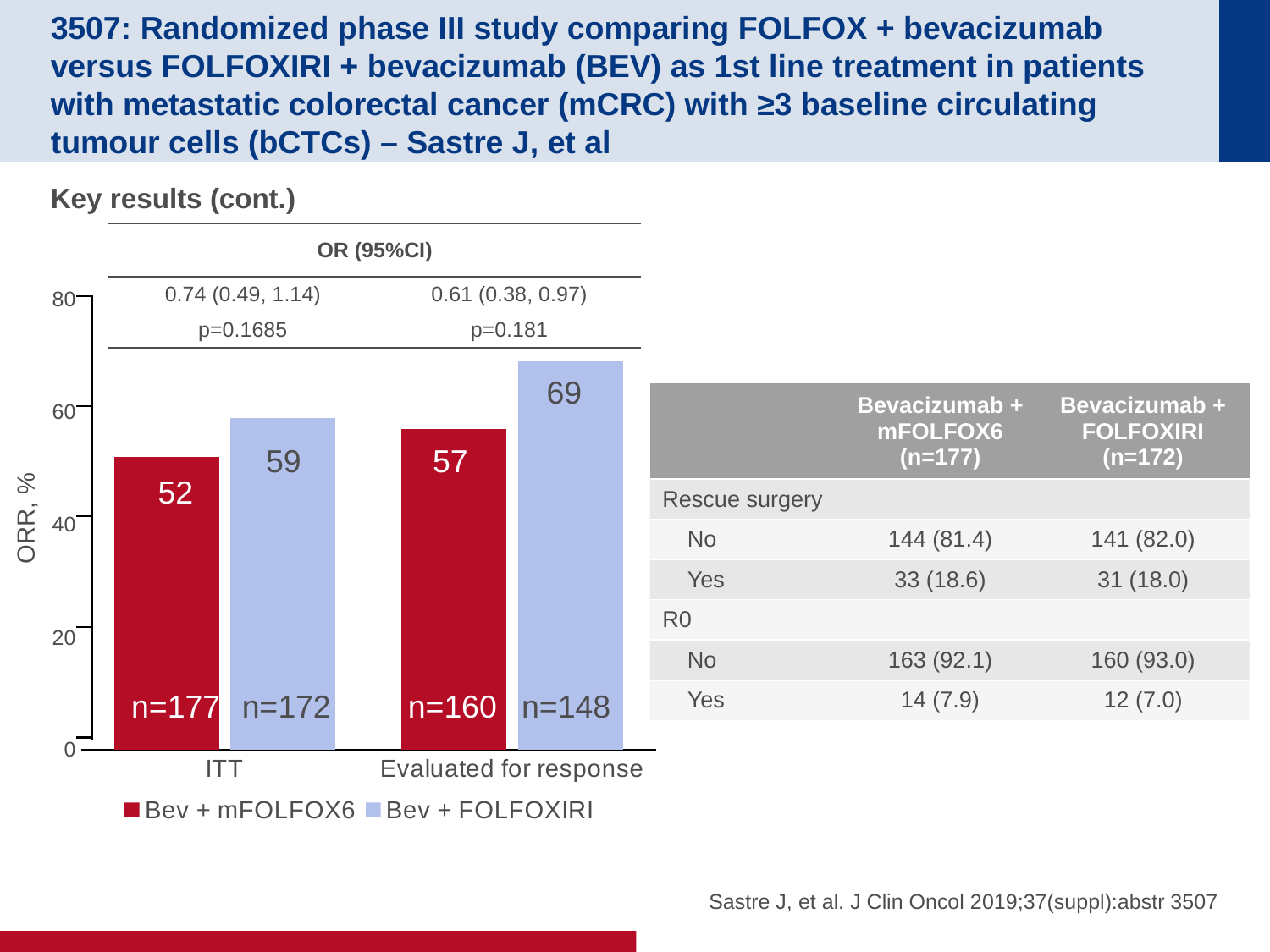
What type of chart is shown on the slide? Bar chart How many categories are shown on the x axis of the chart? 2 What is the ORR for Bev + FOLFOXIRI in the ITT population? 59 What is the ORR for Bev + FOLFOXIRI in the Evaluated for response group? 69 How many series does the chart legend list? 2 Which bar shows the lowest ORR? Bev + mFOLFOX6, ITT What is the difference in ORR between Bev + FOLFOXIRI and Bev + mFOLFOX6 in the Evaluated for response group? 12 In the ITT population, which arm has the higher ORR, Bev + mFOLFOX6 or Bev + FOLFOXIRI? Bev + FOLFOXIRI What is the label of the y axis of the chart? ORR, % What is the ORR for Bev + mFOLFOX6 in the ITT population? 52 Which bar shows the highest ORR? Bev + FOLFOXIRI, Evaluated for response What is the ORR for Bev + mFOLFOX6 in the Evaluated for response group? 57